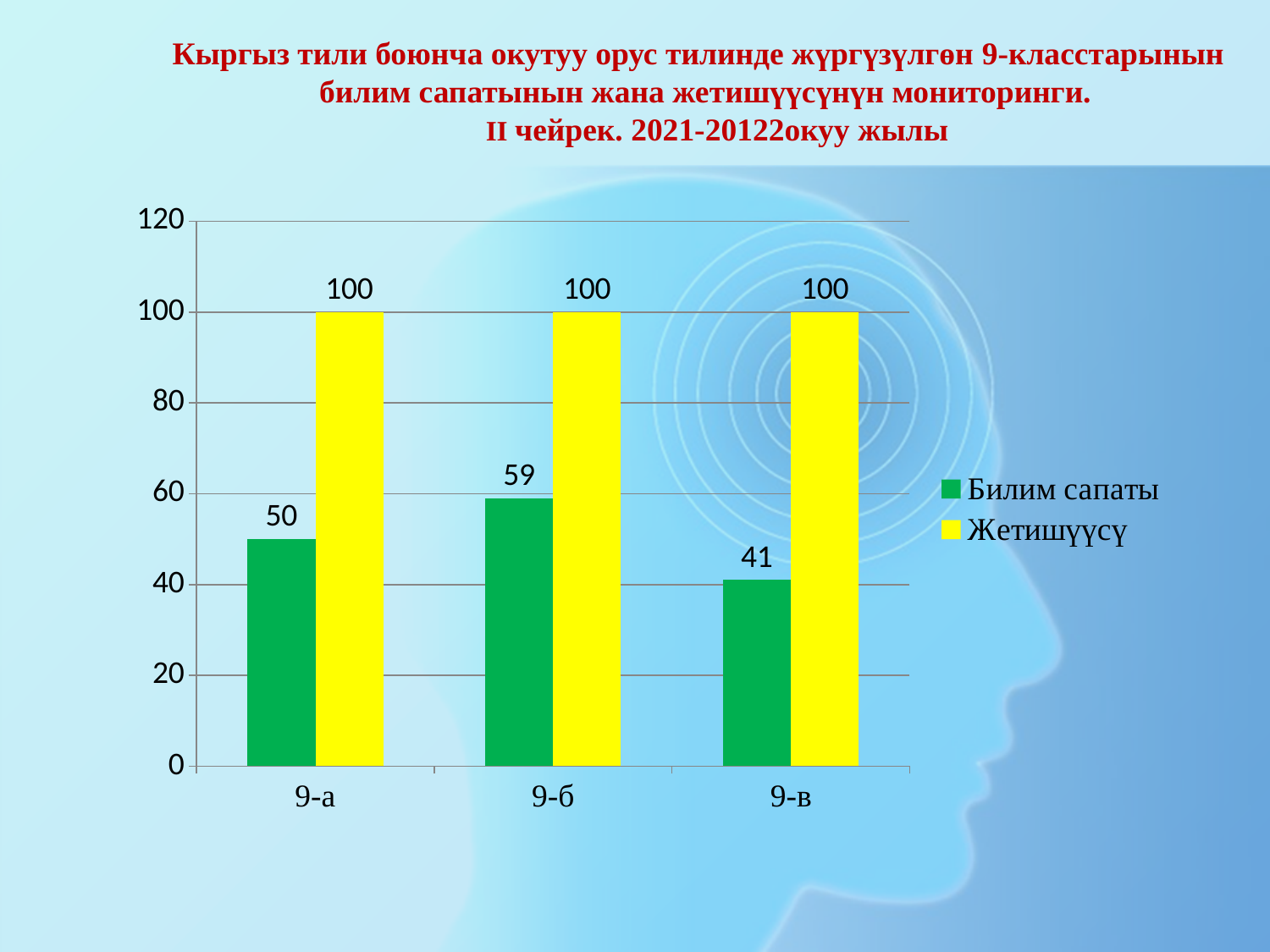
Which class has the lowest Билим сапаты value? 9-в How many classes are shown on the x axis? 3 What is the difference between the Билим сапаты values for 9-б and 9-в? 18 What is the value of Билим сапаты for 9-а? 50 What is the value of Билим сапаты for 9-б? 59 What colour are the Жетишүүсү bars? yellow Which is larger, the Билим сапаты value for 9-а or for 9-в? 9-а Which class has the highest Билим сапаты value? 9-б What is the value of Жетишүүсү for 9-б? 100 How many series does the legend list? 2 What kind of chart is shown on the slide? bar chart What is the value of Билим сапаты for 9-в? 41